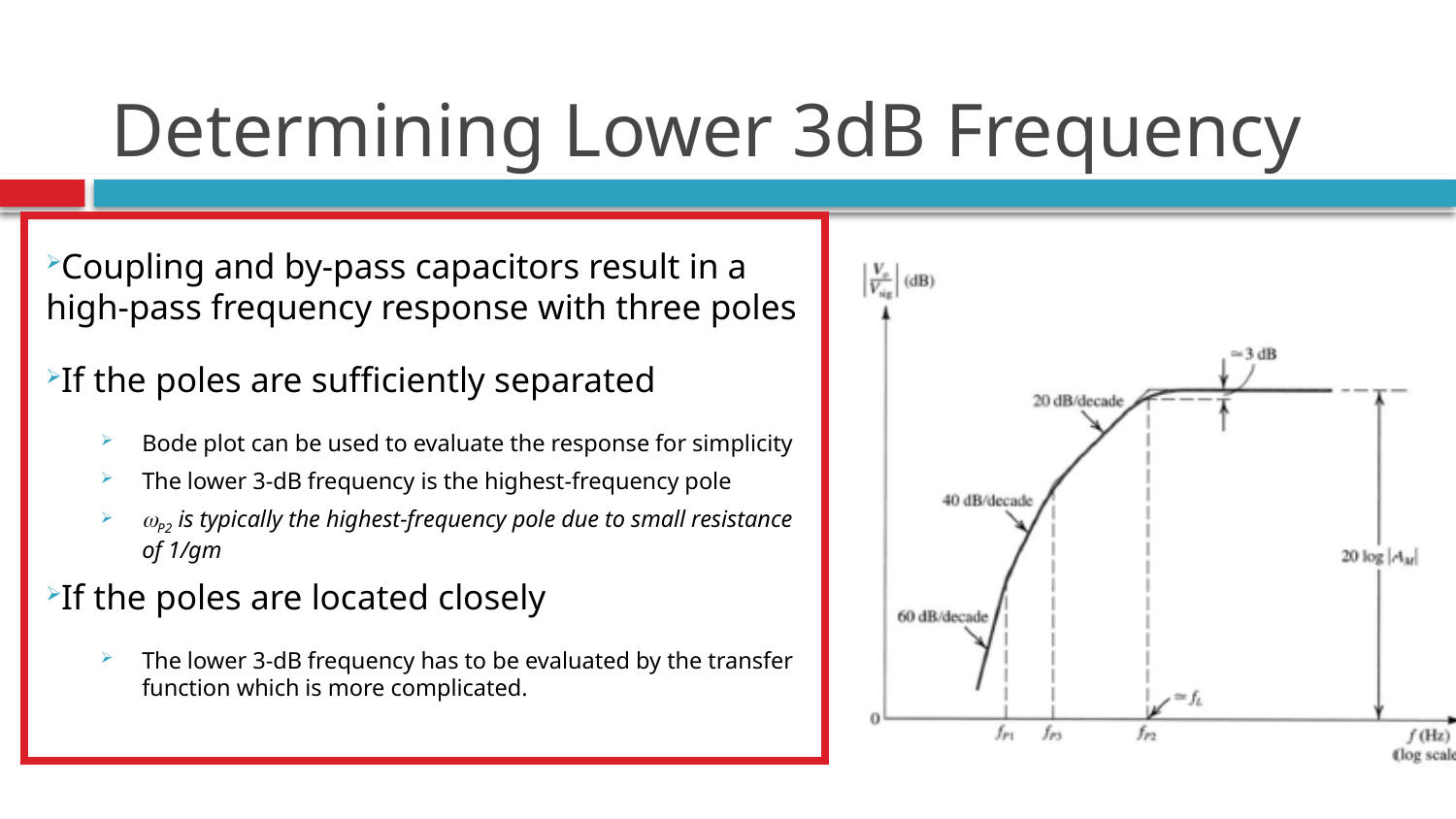
How many pole frequencies are marked on the x axis of the plot? 3 Which marked pole frequency is the highest on the x axis? f_P2 What label gives the height of the flat midband level of the curve? 20 log |A_M| What is the labelled drop between the flat high-frequency level and the curve at f_P2? ≈3 dB What slope is labelled on the lowest-frequency segment of the curve? 60 dB/decade What kind of chart is shown on the right of the slide? line chart What slope is labelled on the segment of the curve between f_P3 and f_P2? 20 dB/decade What slope is labelled on the segment of the curve between f_P1 and f_P3? 40 dB/decade What is the x axis of the plot labelled? f (Hz) (log scale) Does the plotted curve rise or fall as frequency increases along the x axis? rise Which marked pole frequency is the lowest on the x axis? f_P1 Which is larger on the x axis, f_P2 or f_P1? f_P2